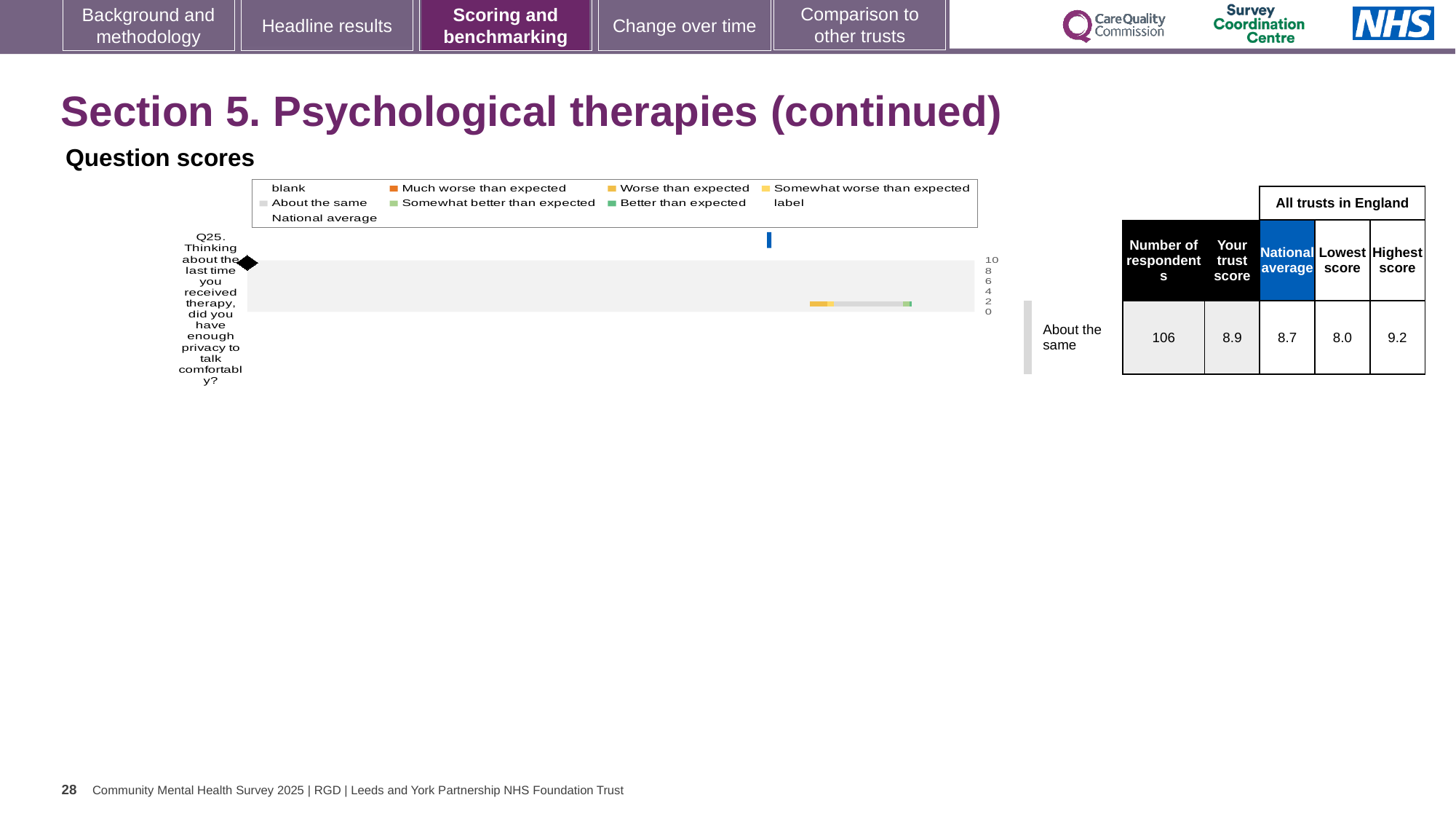
What benchmark category is Q25 assigned to on this slide? About the same Which is larger for Q25, the trust score or the national average? the trust score How many respondents answered Q25? 106 By how much does the trust score for Q25 exceed the national average? 0.2 What is the national average score for Q25? 8.7 What is the highest score among all trusts in England for Q25? 9.2 What is the difference between the highest and lowest scores for Q25 across all trusts in England? 1.2 What kind of chart is shown under 'Question scores'? bar chart What is the trust score for Q25 shown in the table next to the chart? 8.9 How many survey questions are plotted in the Question scores chart? 1 What is the highest tick value shown on the chart's score axis? 10 What is the lowest score among all trusts in England for Q25? 8.0